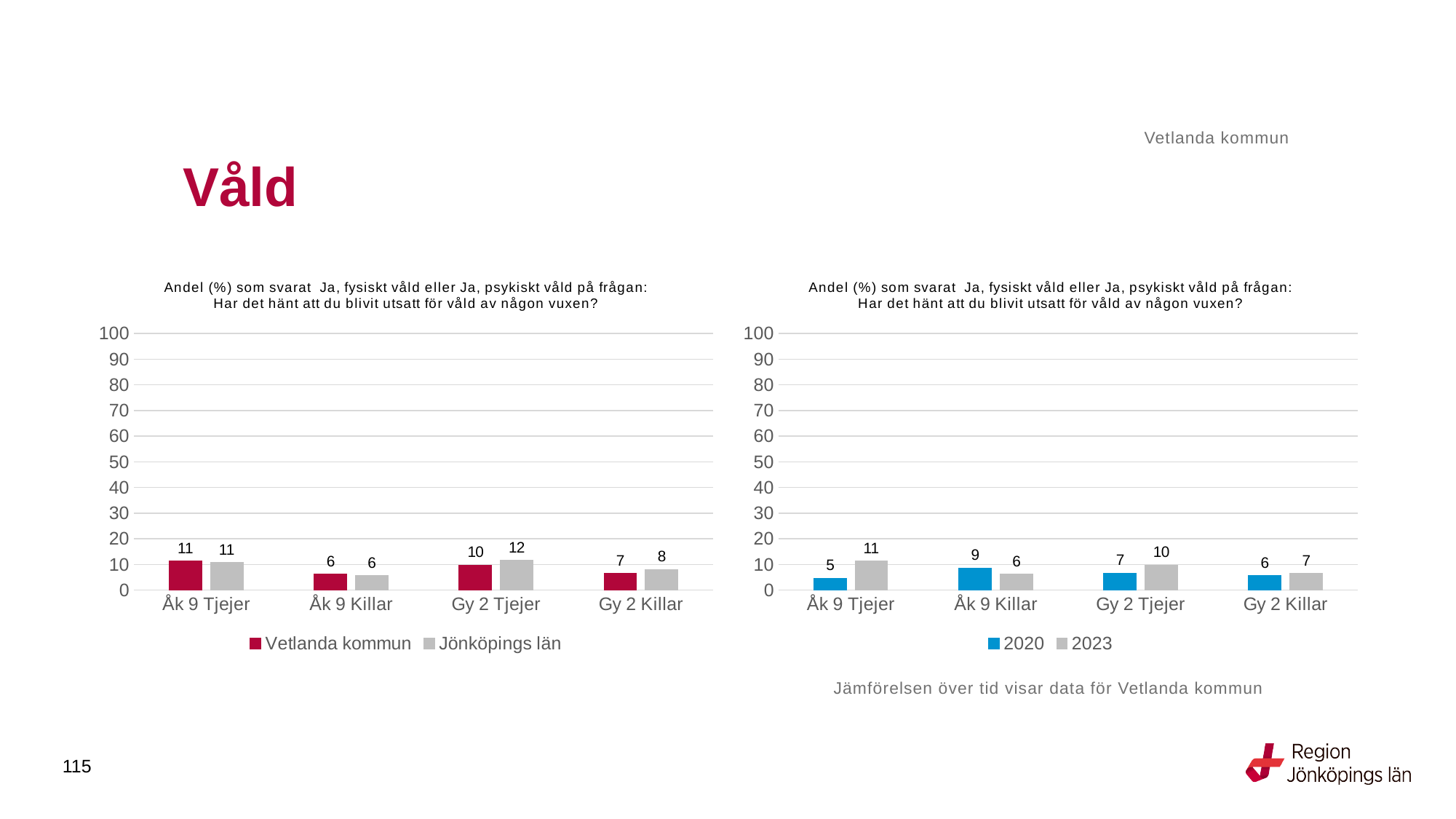
How many series does the legend of the right chart list? 2 How many categories are shown on the x axis of the left chart? 4 In the left chart, what is the value for Jönköpings län for Gy 2 Killar? 8 In the right chart, which category has the highest value for 2023? Åk 9 Tjejer In the right chart, what is the value for 2023 for Åk 9 Tjejer? 11 In the right chart, what is the difference between the 2023 and 2020 values for Åk 9 Tjejer? 6 In the left chart, which category has the lowest value for Vetlanda kommun? Åk 9 Killar What kind of chart is the left chart? Bar chart In the right chart, which is larger for Åk 9 Killar: 2020 or 2023? 2020 In the left chart, what is the value for Vetlanda kommun for Gy 2 Tjejer? 10 In the right chart, what is the value for 2020 for Åk 9 Killar? 9 In the left chart, which is larger for Gy 2 Tjejer: Vetlanda kommun or Jönköpings län? Jönköpings län